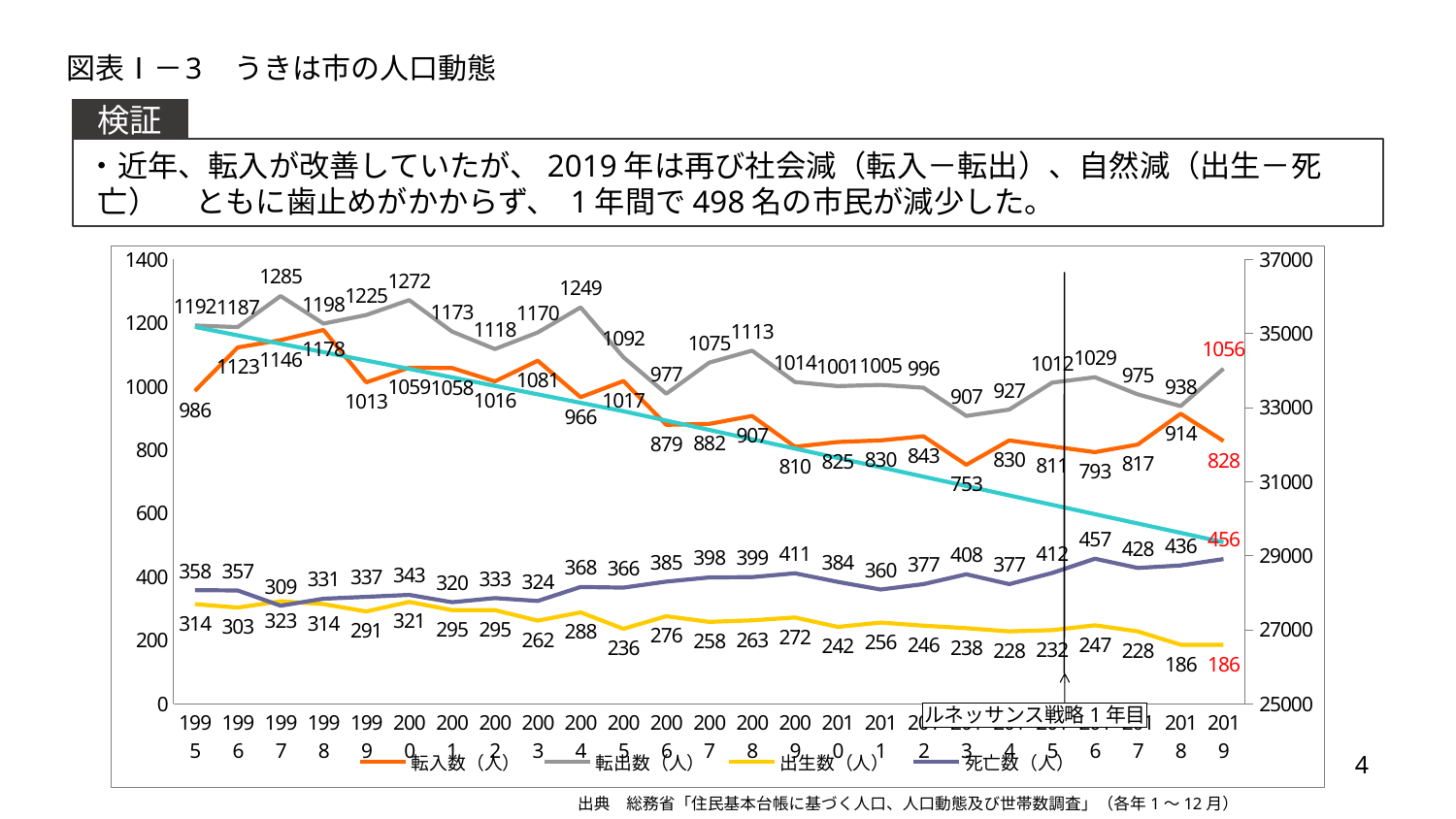
What is the lowest value of 出生数（人） shown on the chart? 186 What is the value of 転出数（人） in 2019? 1056 What is the difference between 転出数（人） and 転入数（人） in 2019? 228 What is the value of 転入数（人） in 2019? 828 What is the value of 死亡数（人） in 2016? 457 In which year is 転出数（人） highest? 1997 What kind of chart is shown on the slide? line chart What is the difference between 死亡数（人） and 出生数（人） in 2019? 270 Does 出生数（人） generally rise or fall from 1995 to 2019? fall Which is larger in 2019, 死亡数（人） or 出生数（人）? 死亡数（人） What is the lowest value of 転入数（人） shown on the chart? 753 How many series does the legend list? 4